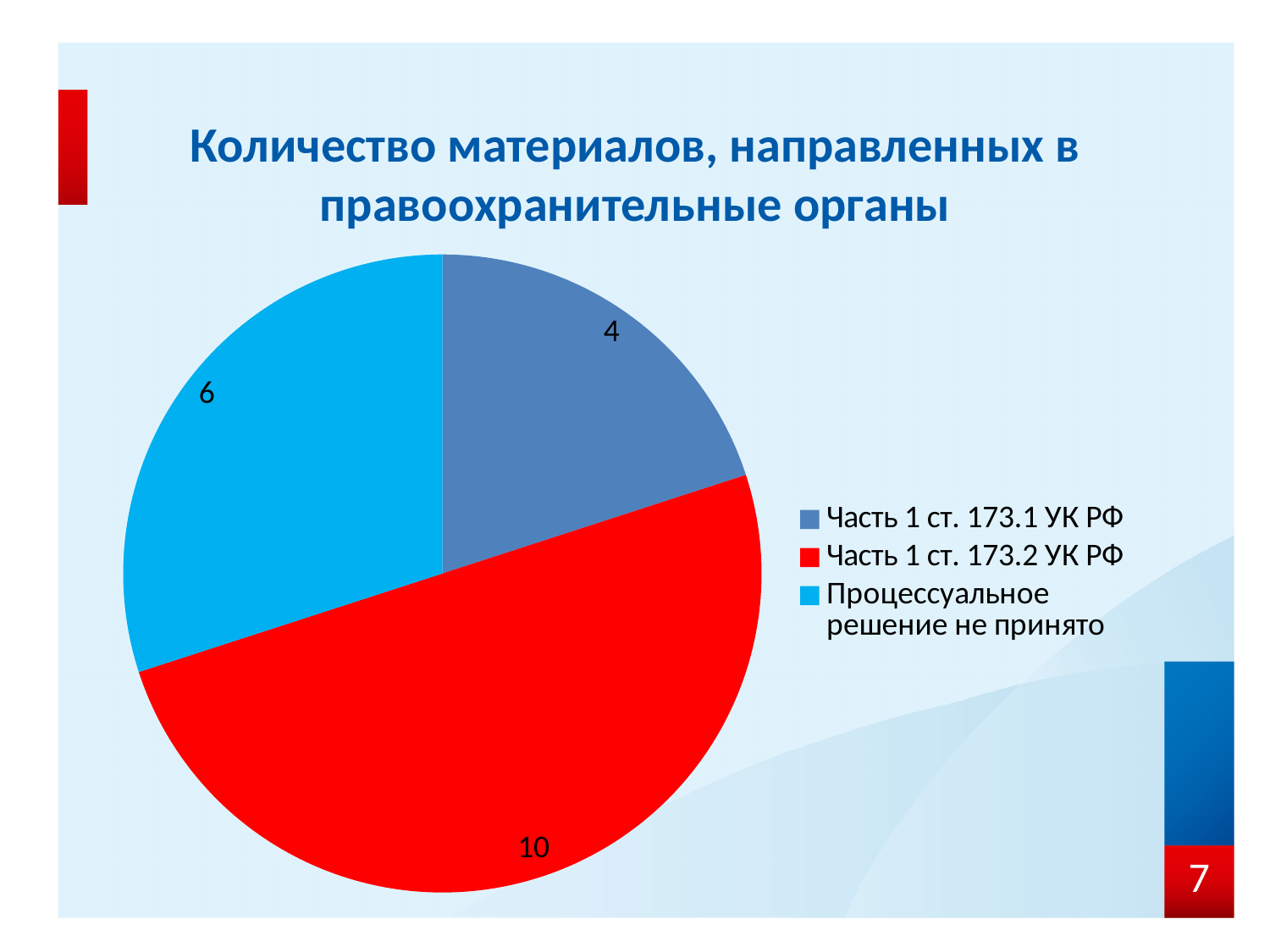
What is the value for Процессуальное решение не принято? 6 What is the value for Часть 1 ст. 173.2 УК РФ? 10 What is the value for Часть 1 ст. 173.1 УК РФ? 4 What share of the pie does Часть 1 ст. 173.2 УК РФ represent? 50% What share of the pie does Процессуальное решение не принято represent? 30% Which category has the largest slice? Часть 1 ст. 173.2 УК РФ How many slices does the pie chart have? 3 What is the title of the chart? Количество материалов, направленных в правоохранительные органы Which category has the smallest slice? Часть 1 ст. 173.1 УК РФ Which is larger: the value for Процессуальное решение не принято or the value for Часть 1 ст. 173.1 УК РФ? Процессуальное решение не принято What type of chart is shown on the slide? pie chart What is the difference between the values for Часть 1 ст. 173.2 УК РФ and Часть 1 ст. 173.1 УК РФ? 6